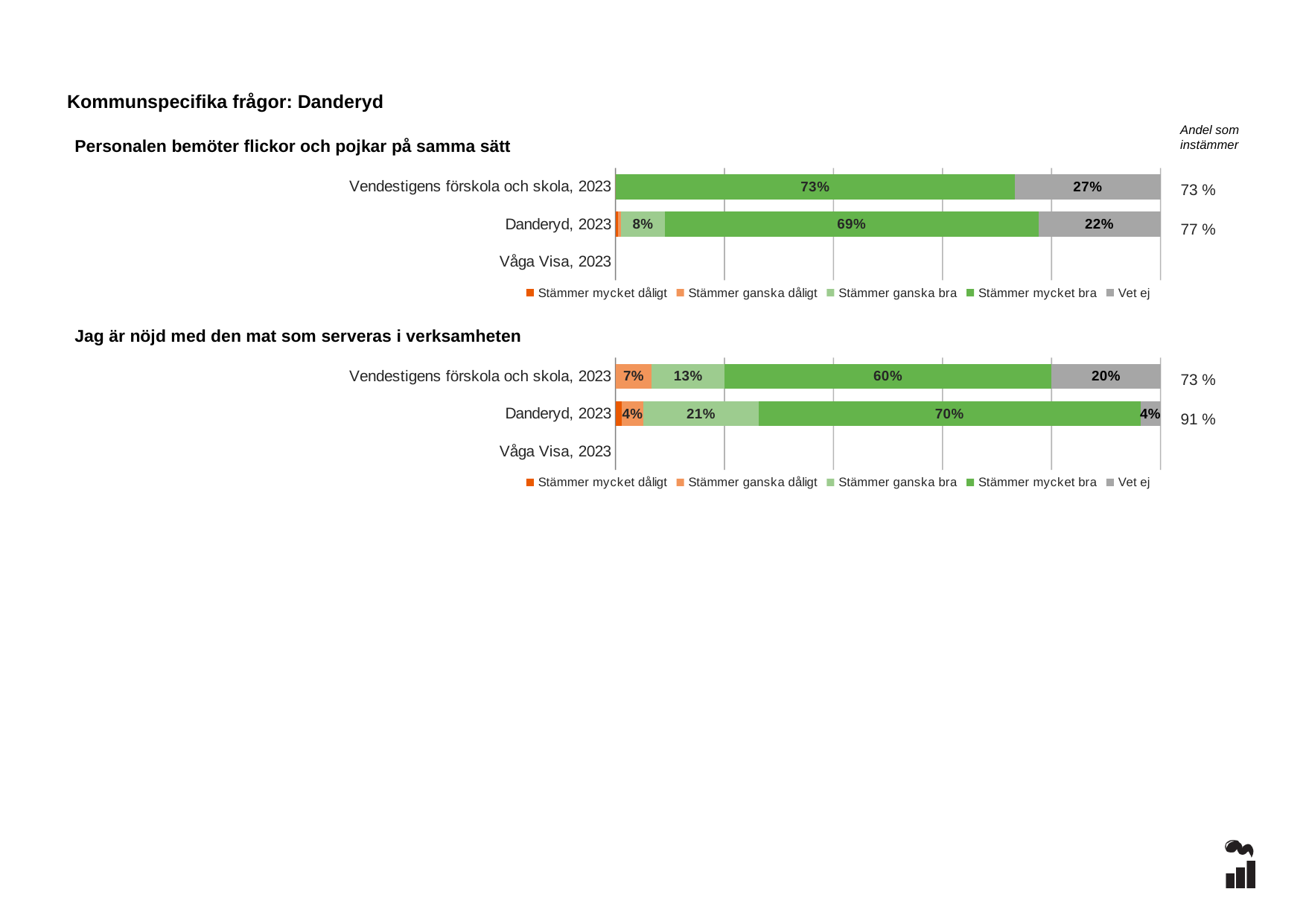
In the chart 'Personalen bemöter flickor och pojkar på samma sätt', what is the 'Vet ej' value for Danderyd, 2023? 22% In the chart 'Jag är nöjd med den mat som serveras i verksamheten', what is the 'Stämmer mycket bra' value for Danderyd, 2023? 70% In the chart 'Jag är nöjd med den mat som serveras i verksamheten', what is the 'Stämmer ganska dåligt' value for Vendestigens förskola och skola, 2023? 7% In the chart 'Jag är nöjd med den mat som serveras i verksamheten', what is the 'Andel som instämmer' shown for Danderyd, 2023? 91 % In the chart 'Personalen bemöter flickor och pojkar på samma sätt', which row has the higher 'Stämmer mycket bra' value: Vendestigens förskola och skola, 2023 or Danderyd, 2023? Vendestigens förskola och skola, 2023 In the chart 'Personalen bemöter flickor och pojkar på samma sätt', what is the 'Stämmer mycket bra' value for Vendestigens förskola och skola, 2023? 73% In the chart 'Jag är nöjd med den mat som serveras i verksamheten', which has the larger 'Vet ej' value: Vendestigens förskola och skola, 2023 or Danderyd, 2023? Vendestigens förskola och skola, 2023 What kind of chart is 'Personalen bemöter flickor och pojkar på samma sätt'? Stacked bar chart How many series does the legend of the chart 'Jag är nöjd med den mat som serveras i verksamheten' list? 5 In the chart 'Personalen bemöter flickor och pojkar på samma sätt', what is the 'Andel som instämmer' shown for Danderyd, 2023? 77 % In the chart 'Personalen bemöter flickor och pojkar på samma sätt', what is the 'Stämmer ganska bra' value for Danderyd, 2023? 8% In the chart 'Jag är nöjd med den mat som serveras i verksamheten', what is the difference between the 'Stämmer mycket bra' values for Danderyd, 2023 and Vendestigens förskola och skola, 2023? 10%